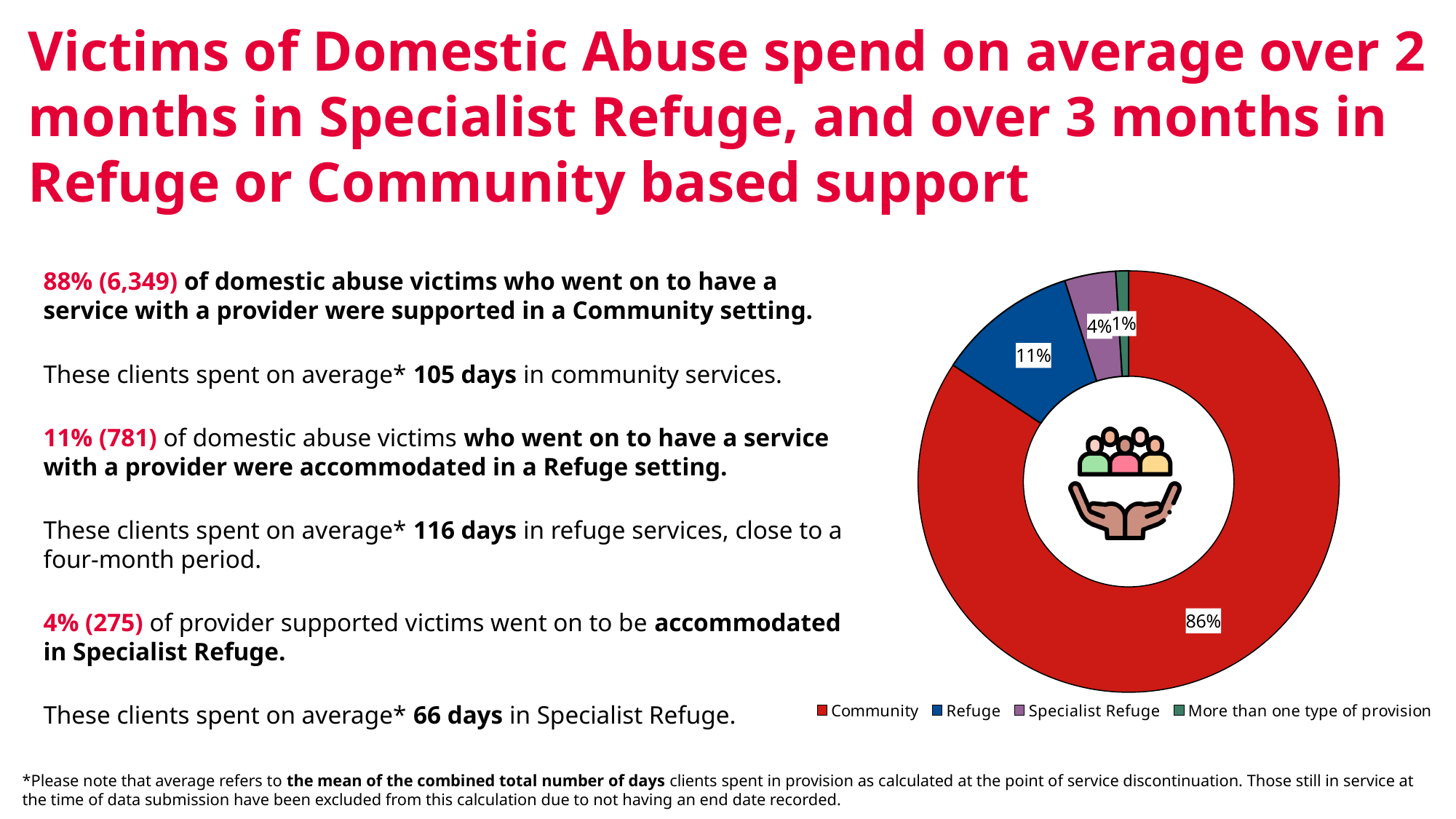
What percentage does the Refuge slice show in the pie chart? 11% What percentage does the 'More than one type of provision' slice show in the pie chart? 1% What colour is the Refuge slice in the pie chart? Blue What colour is the Community slice in the pie chart? Red What percentage does the Specialist Refuge slice show in the pie chart? 4% What percentage does the Community slice show in the pie chart? 86% How many categories does the legend of the pie chart list? 4 Which category has the largest slice in the pie chart? Community Which slice is larger in the pie chart, Refuge or Specialist Refuge? Refuge What is the difference in percentage points between the Community slice and the Refuge slice? 75 Which category has the smallest slice in the pie chart? More than one type of provision What kind of chart is shown on the slide? Pie chart (donut)